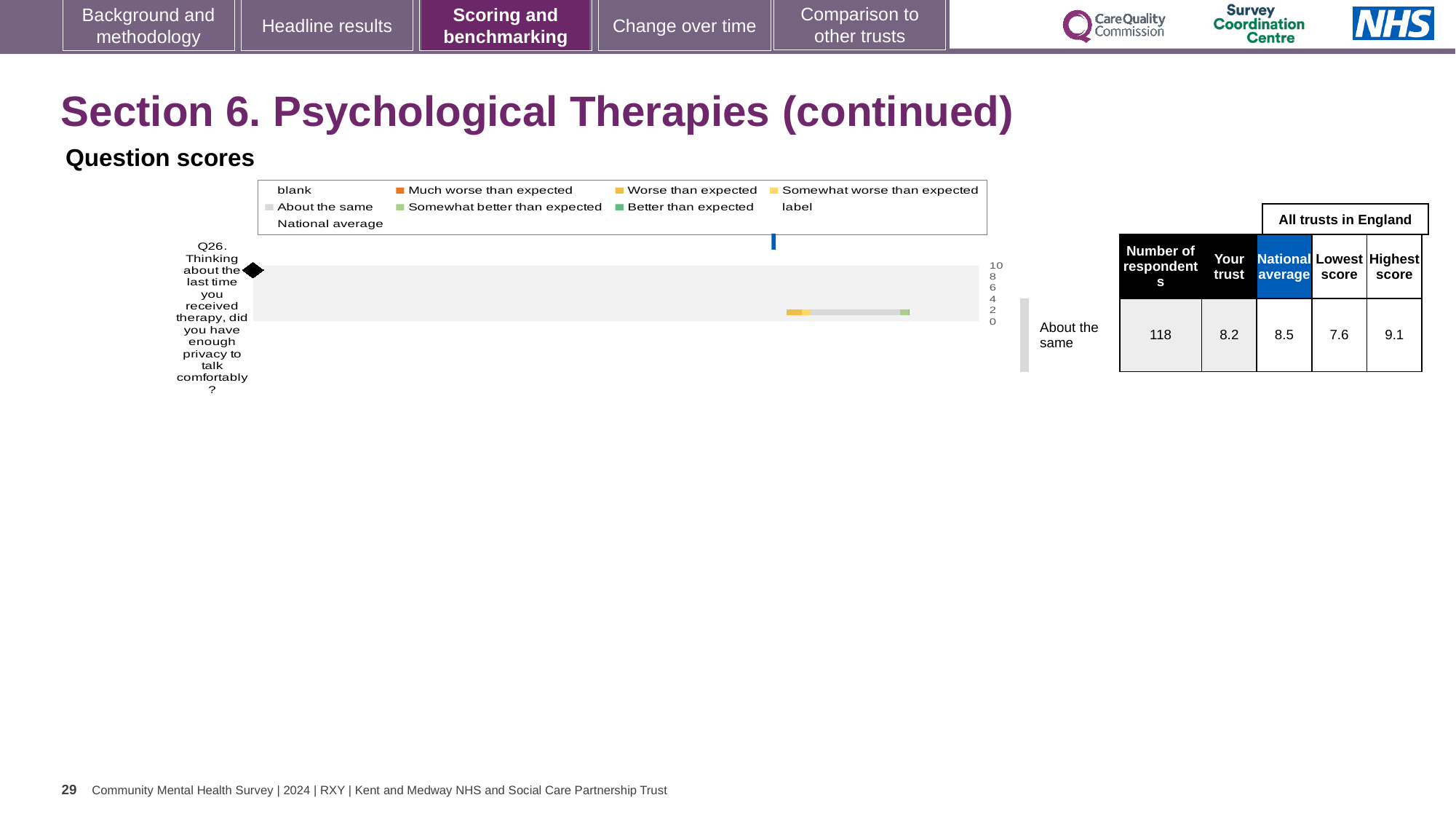
Is the 'Your trust' score for Q26 greater or less than 8? greater Which benchmarking category is Q26 placed in? About the same What is the highest score among all trusts in England for Q26? 9.1 What kind of chart is shown on the slide? Bar chart What is the national average score for Q26? 8.5 What is the difference between the national average and the 'Your trust' score for Q26? 0.3 How many questions are plotted on the chart? 1 What is the lowest score among all trusts in England for Q26? 7.6 How many respondents answered Q26? 118 What is the 'Your trust' score for Q26 shown in the table next to the chart? 8.2 Which is larger for Q26: the 'Your trust' score or the national average? National average What is the difference between the highest score and the lowest score for Q26? 1.5